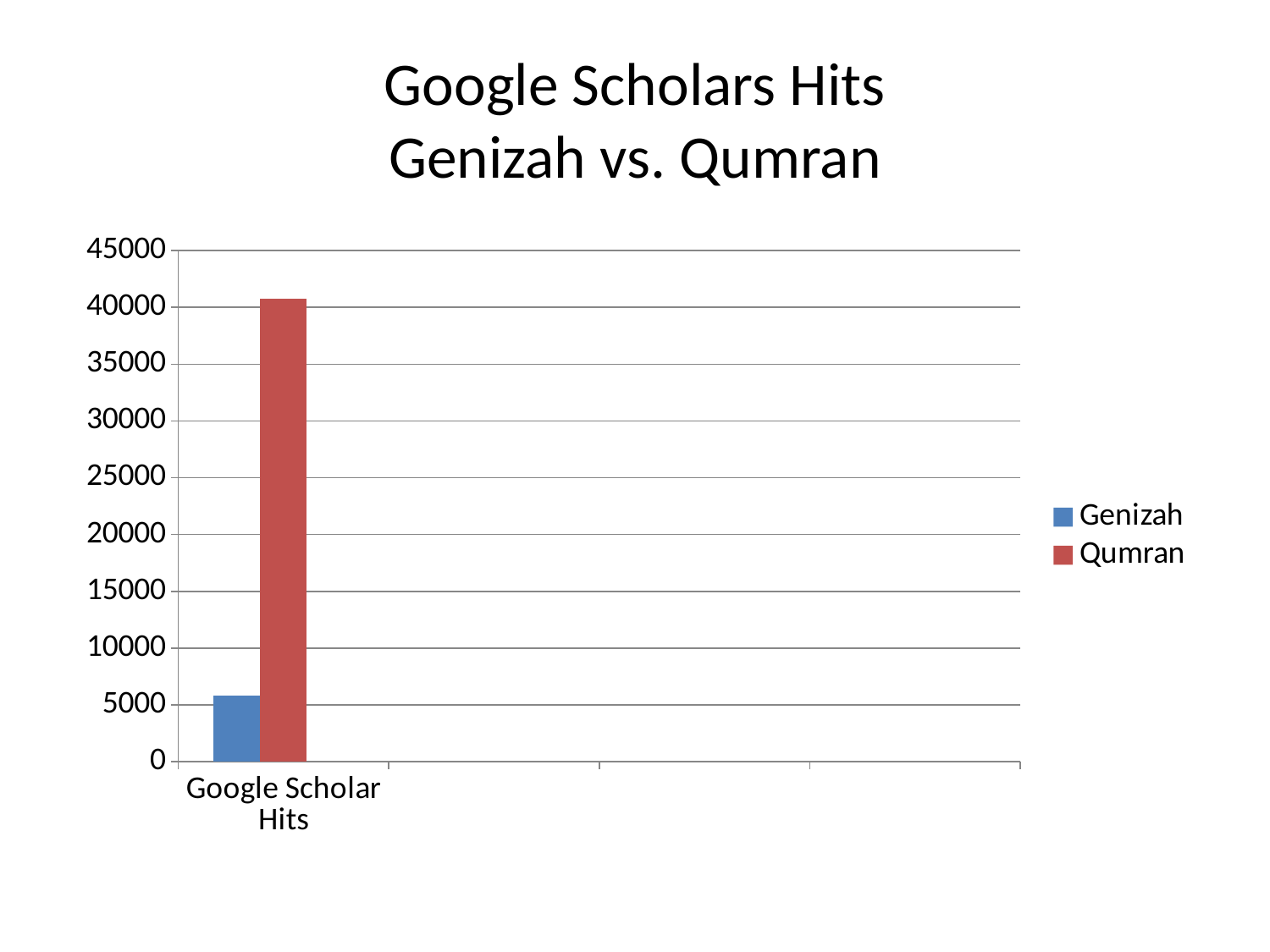
Is the value for Genizah greater or less than 10000? less Is the value for Genizah larger or smaller than the value for Qumran? smaller What colour is the bar for Qumran? red Which series has the lower value for Google Scholar Hits? Genizah Is the value for Qumran greater or less than 35000? greater What kind of chart is shown on the slide? bar chart Is the value for Qumran greater or less than 45000? less How many series does the legend list? 2 What is the title of the chart? Google Scholars Hits Genizah vs. Qumran How many categories are shown on the x axis? 1 Which series has the higher value for Google Scholar Hits? Qumran